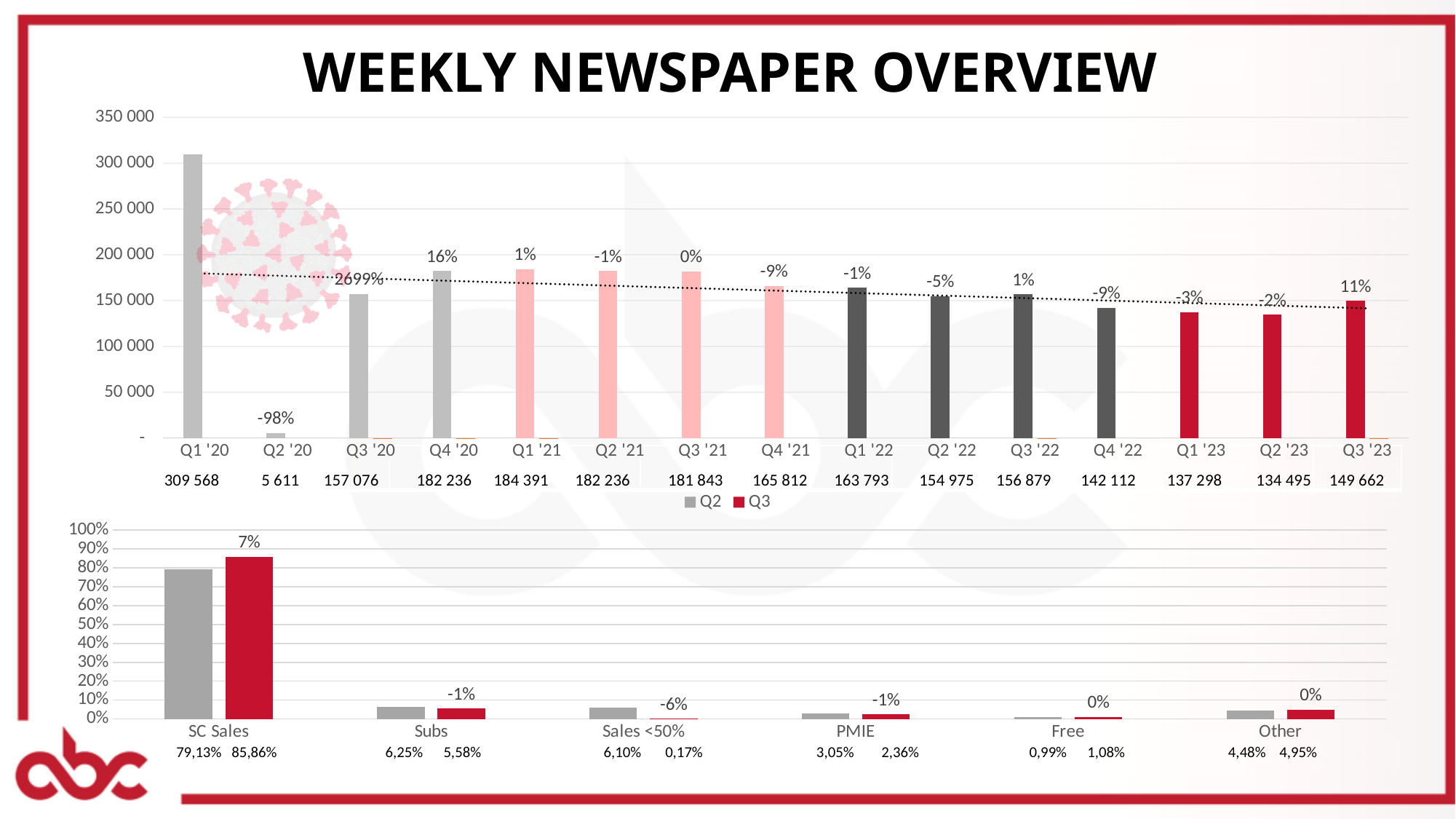
In the bottom chart, what is the Q2 value for Sales <50%? 6,10% In the bottom chart, how many categories are shown on the x axis? 6 How many series does the legend list? 2 In the top chart, is the value for Q1 '20 greater or less than 300 000? greater In the top chart, what percentage change label is shown above the Q3 '23 bar? 11% In the top chart, how many quarters are plotted? 15 In the top chart, which quarter has the lowest value? Q2 '20 In the top chart, what is the value for Q3 '23? 149 662 In the bottom chart, which is larger for Free: the Q2 value or the Q3 value? Q3 In the top chart, what is the difference between the values for Q3 '23 and Q2 '23? 15 167 In the top chart, which quarter has the highest value? Q1 '20 In the bottom chart, what is the Q3 value for SC Sales? 85,86%